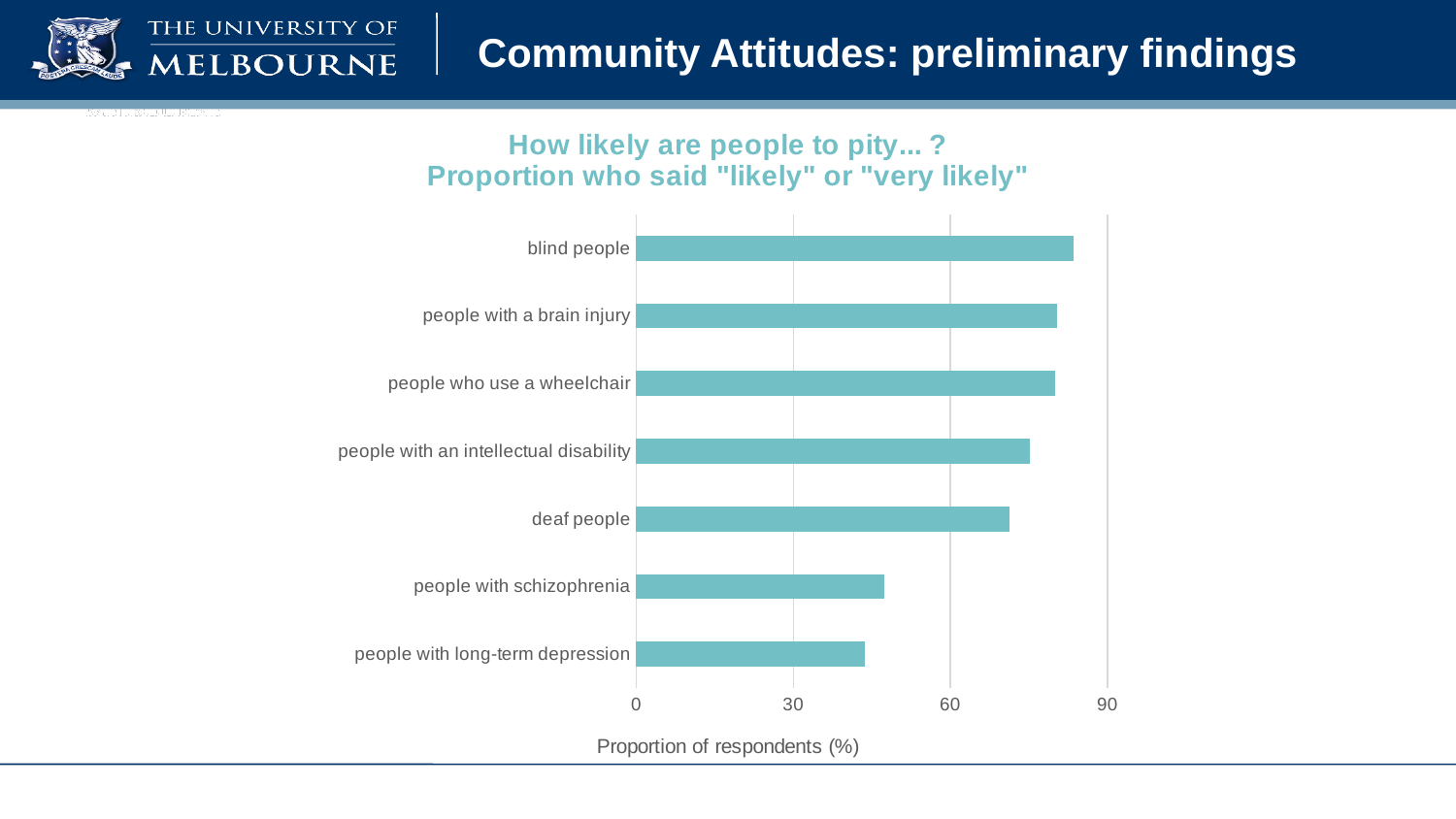
Which group has the highest proportion of respondents saying they would be likely to pity them? blind people Is the value for people with an intellectual disability greater or less than 60? greater What is the label on the horizontal axis of the chart? Proportion of respondents (%) What kind of chart is shown on the slide? bar chart Is the value for blind people greater or less than 90? less Is the value for people with schizophrenia greater or less than 60? less How many categories (groups of people) are shown in the chart? 7 Which is larger: the value for people with long-term depression or the value for people who use a wheelchair? people who use a wheelchair Which group has the lowest proportion of respondents saying they would be likely to pity them? people with long-term depression Which is larger: the value for deaf people or the value for people with schizophrenia? deaf people